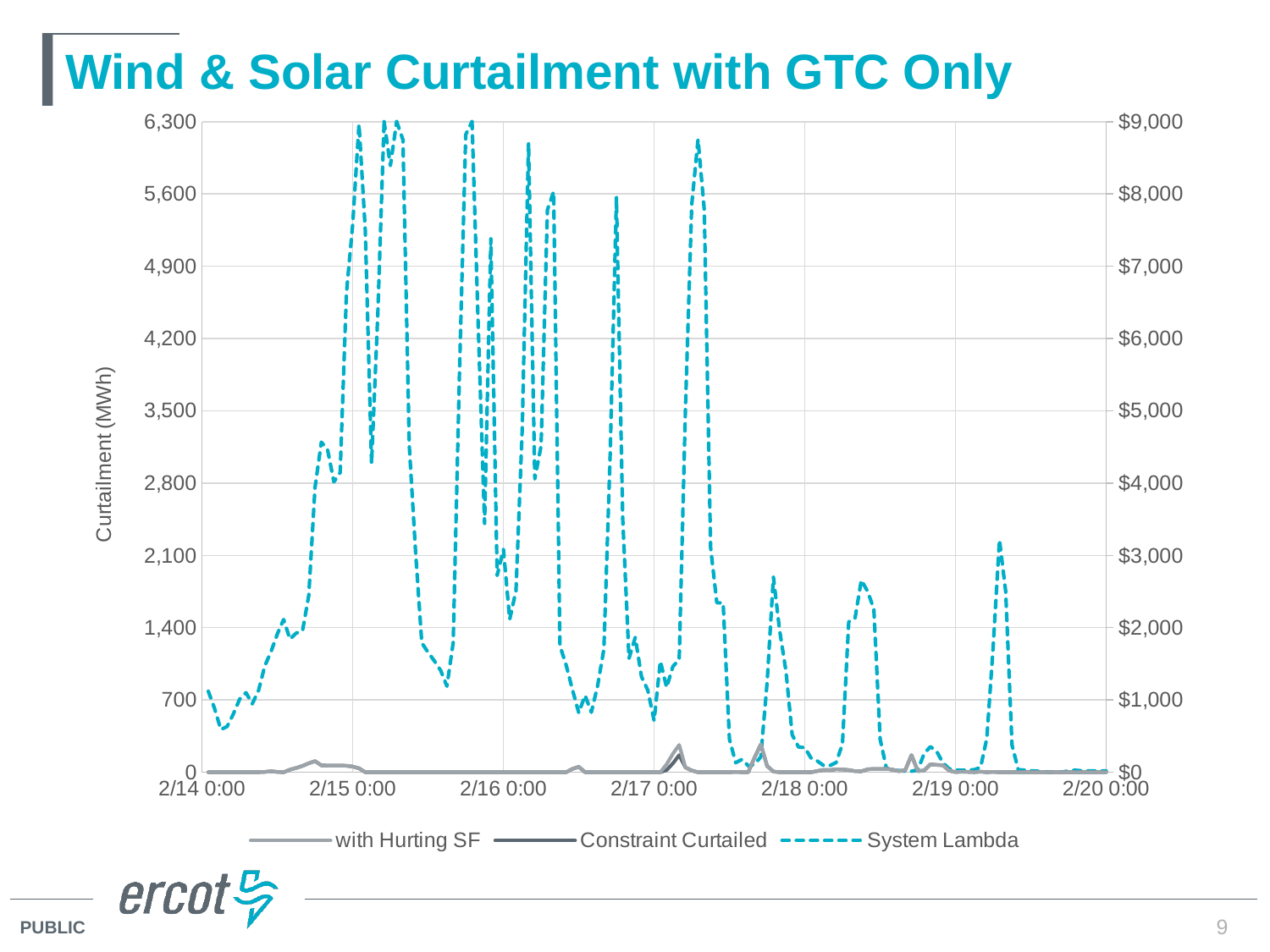
Is the value for with Hurting SF at 2/16 0:00 greater or less than 700? less Is the value for System Lambda at 2/20 0:00 greater or less than $1,000? less What is the title of the chart? Wind & Solar Curtailment with GTC Only Which series is drawn with a dashed line? System Lambda What is the label on the left vertical axis? Curtailment (MWh) How many series does the legend list? 3 How many date labels are shown along the x axis? 7 What kind of chart is shown on the slide? line chart Does the System Lambda line rise or fall between 2/14 0:00 and 2/15 0:00? rise Is the value for System Lambda at 2/18 0:00 greater or less than $1,000? less